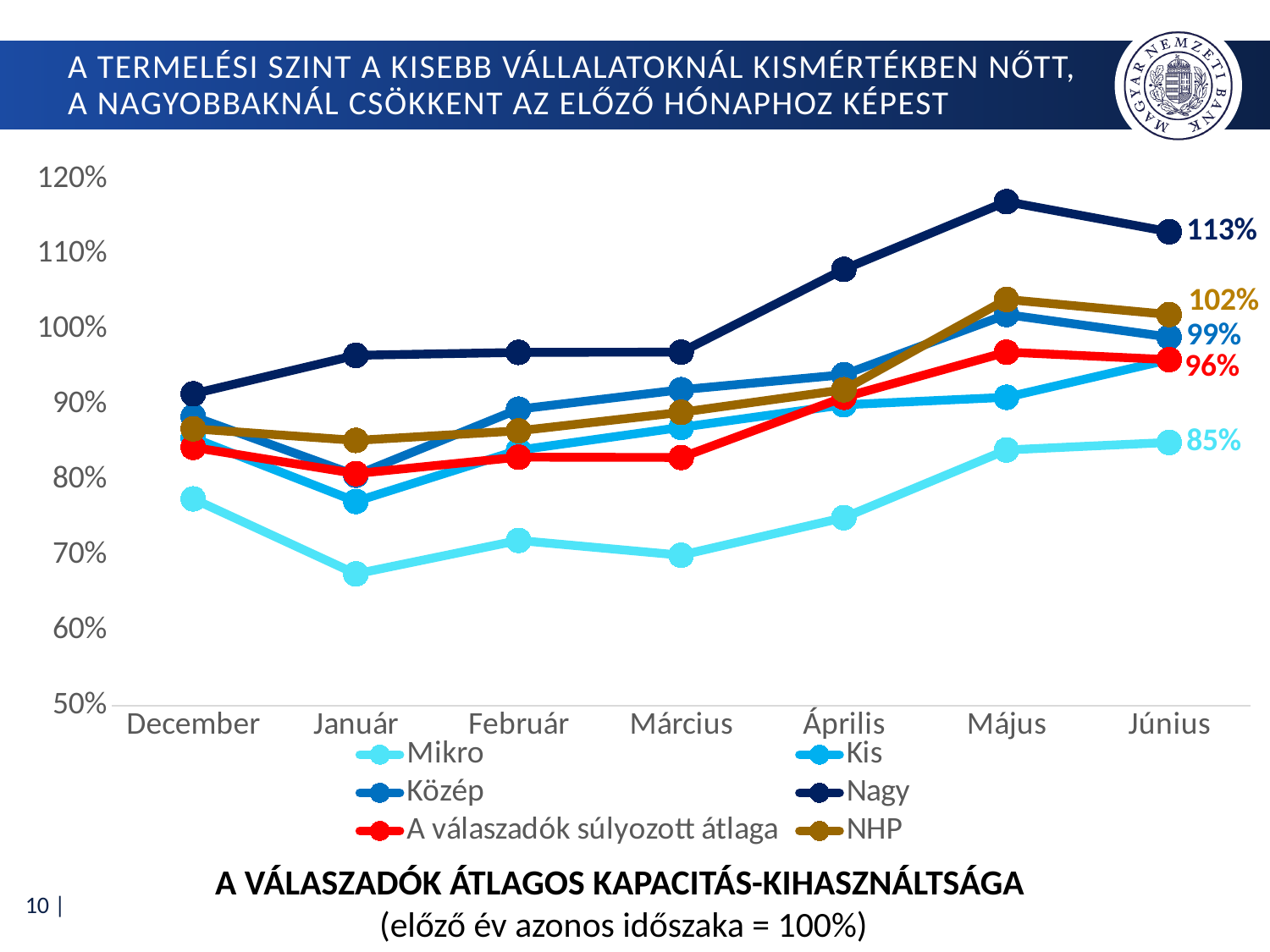
Is the value for Nagy in Május greater or less than 110%? greater How many months are shown on the x axis? 7 What kind of chart is shown on the slide? line chart How many series does the legend list? 6 What is the value for Mikro in Június? 85% What is the value for Nagy in Június? 113% What is the difference between the Nagy and Mikro values in Június? 28 percentage points What is the value for Közép in Június? 99% What is the value for NHP in Június? 102% Which series has the highest value in Június? Nagy Which series has the lowest value in Június? Mikro Is the value for Mikro in Január greater or less than 70%? less